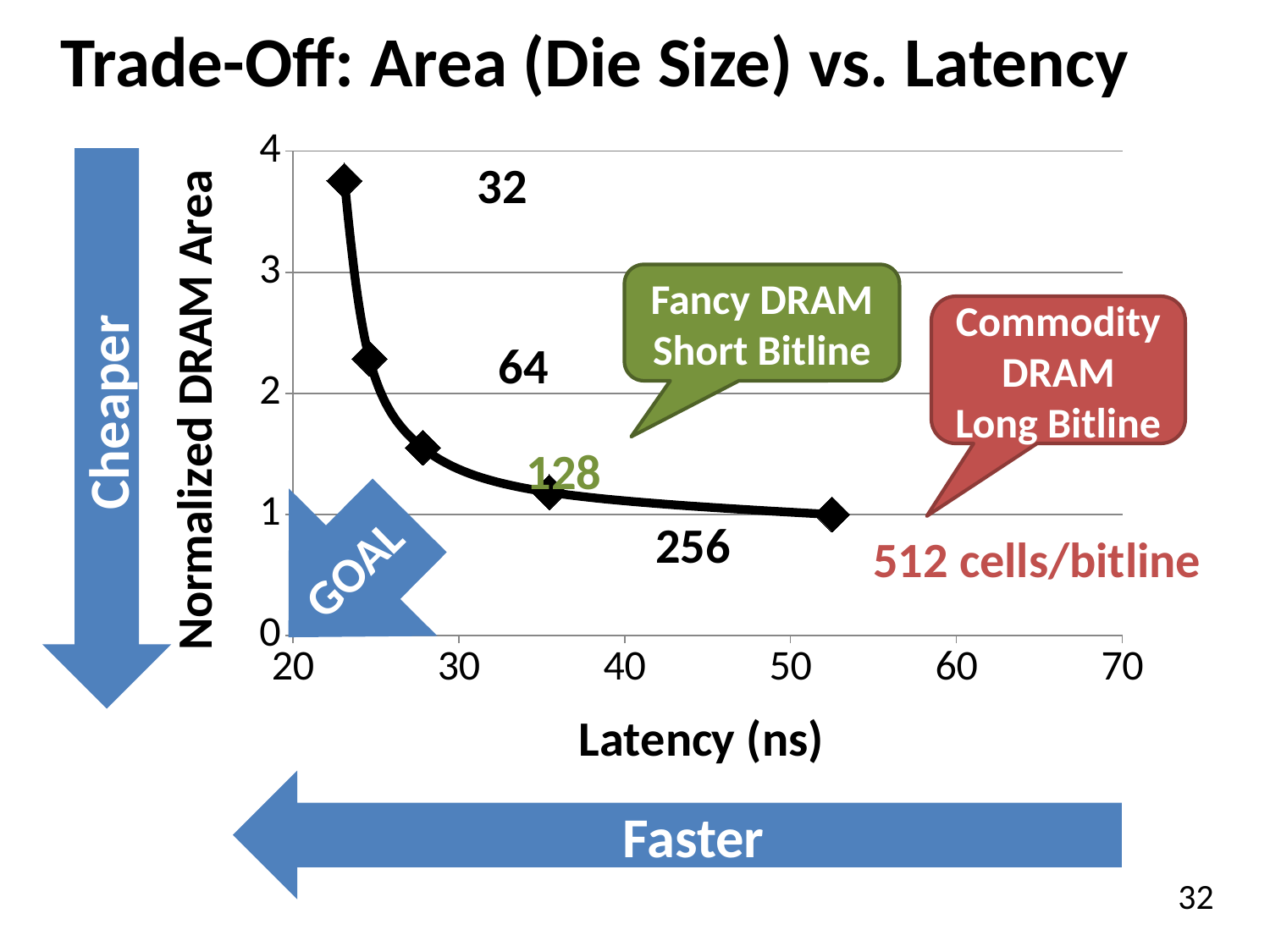
Is the normalized DRAM area for the 256 cells/bitline point greater or less than 2? less What is the label of the y axis? Normalized DRAM Area Is the normalized DRAM area for the 32 cells/bitline point greater or less than 3? greater Which cells/bitline configuration has the highest normalized DRAM area? 32 What kind of chart is shown on the slide? line chart Which cells/bitline configuration has the lowest normalized DRAM area? 512 Is the normalized DRAM area for the 64 cells/bitline point greater or less than 2? greater As latency increases along the x axis, does the normalized DRAM area rise or fall? fall What is the label of the x axis? Latency (ns) Which has the larger normalized DRAM area, the 64 cells/bitline point or the 128 cells/bitline point? 64 How many data points are plotted on the curve? 5